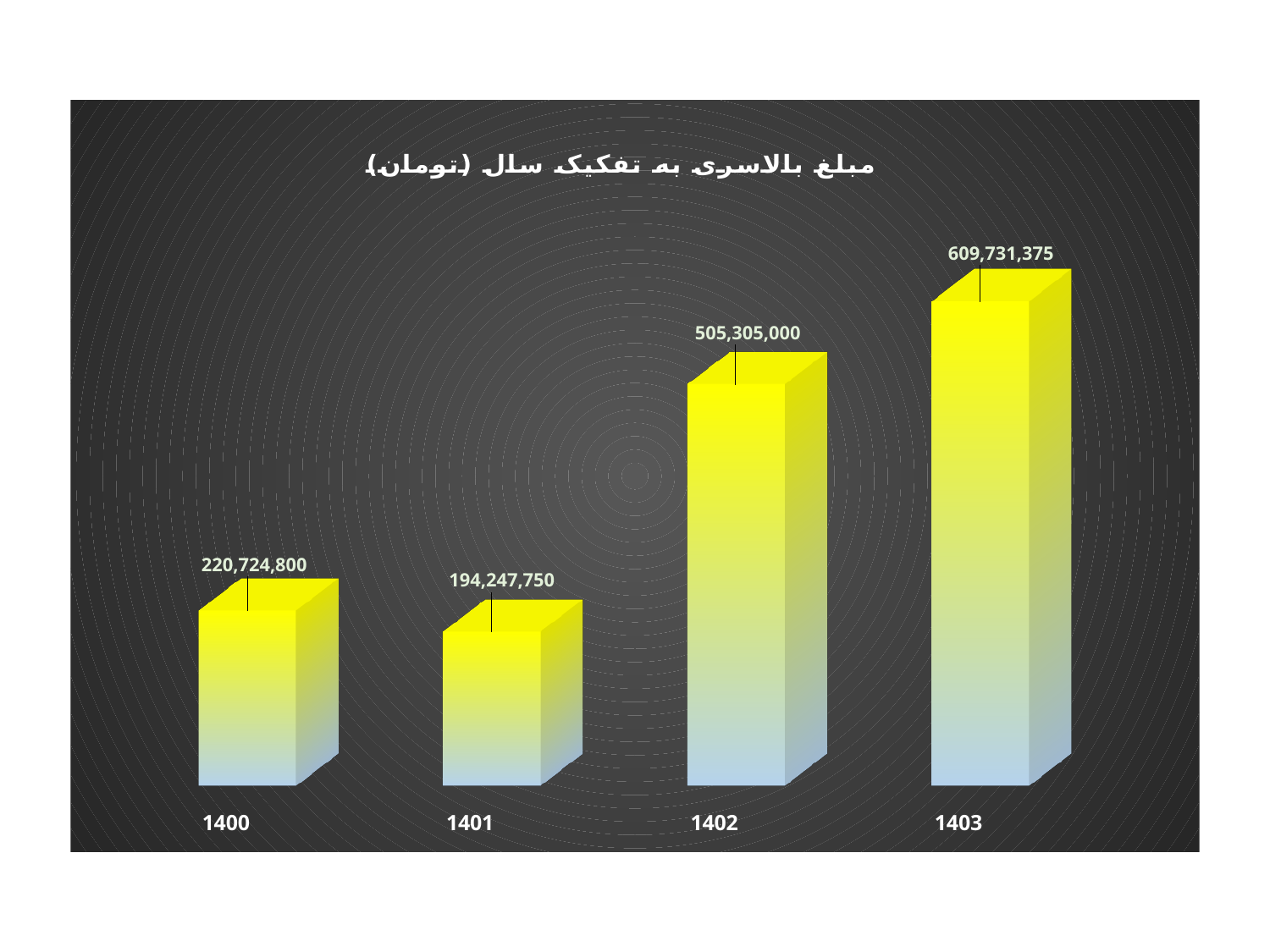
What is the value for 1400? 220,724,800 Does the value rise or fall from 1401 to 1403? rise Which is larger, the value for 1400 or the value for 1401? 1400 What is the value for 1402? 505,305,000 Which year has the lowest value? 1401 How many years are shown on the chart? 4 What is the difference between the values for 1400 and 1401? 26,477,050 What is the value for 1401? 194,247,750 What is the value for 1403? 609,731,375 What is the difference between the values for 1403 and 1402? 104,426,375 Which year has the highest value? 1403 What kind of chart is this? bar chart